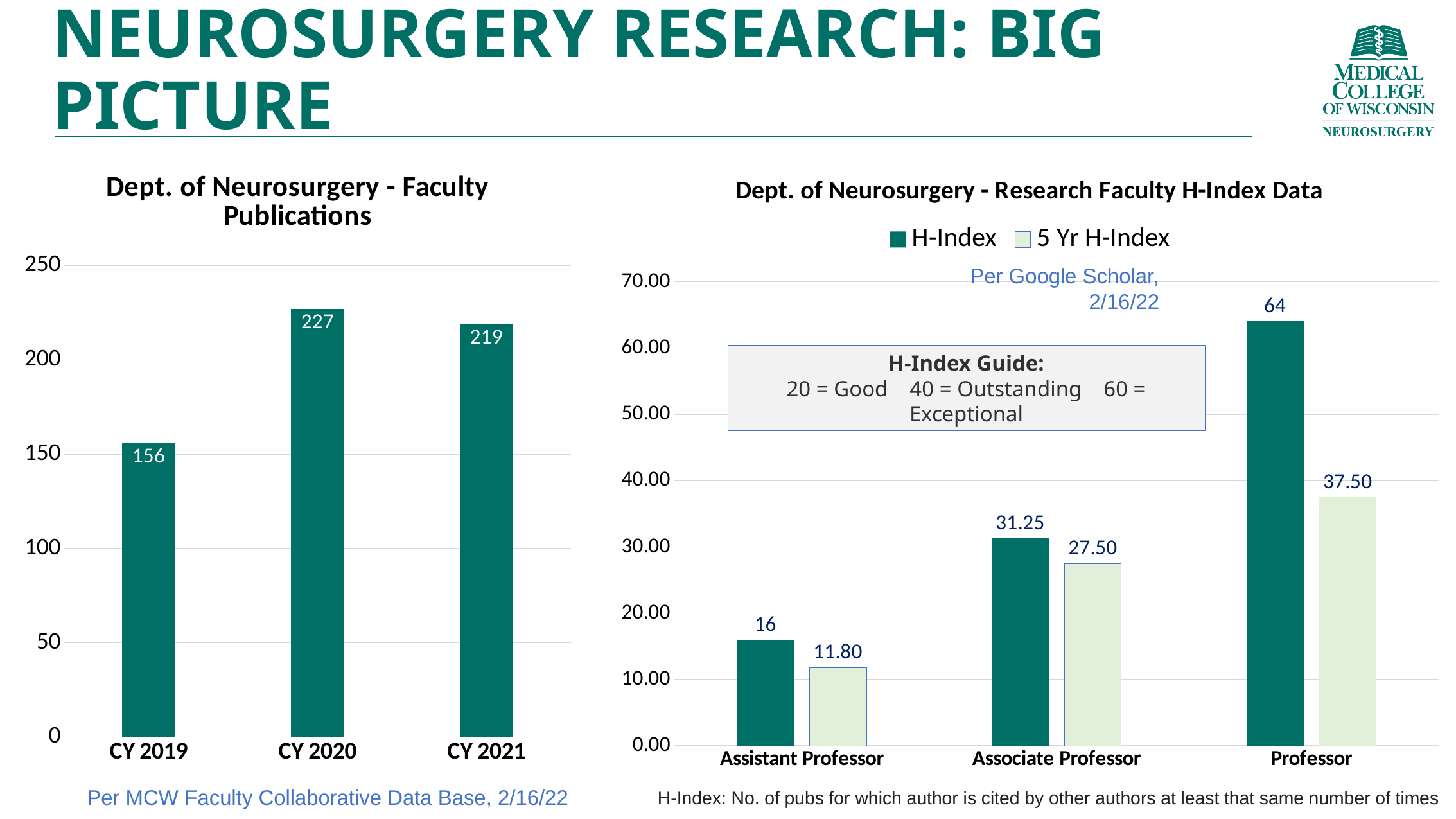
In the 'Dept. of Neurosurgery - Faculty Publications' chart, is the value for CY 2019 greater or less than 150? greater In the 'Dept. of Neurosurgery - Research Faculty H-Index Data' chart, what is the difference between the H-Index and the 5 Yr H-Index for Assistant Professor? 4.20 What kind of chart is the 'Dept. of Neurosurgery - Research Faculty H-Index Data' chart? Bar chart In the 'Dept. of Neurosurgery - Research Faculty H-Index Data' chart, what is the H-Index for Associate Professor? 31.25 In the 'Dept. of Neurosurgery - Faculty Publications' chart, how many years are shown? 3 In the 'Dept. of Neurosurgery - Research Faculty H-Index Data' chart, which is larger: the 5 Yr H-Index for Associate Professor or the H-Index for Assistant Professor? 5 Yr H-Index for Associate Professor In the 'Dept. of Neurosurgery - Faculty Publications' chart, what is the difference between CY 2020 and CY 2021? 8 In the 'Dept. of Neurosurgery - Research Faculty H-Index Data' chart, how many series does the legend list? 2 In the 'Dept. of Neurosurgery - Faculty Publications' chart, which year has the lowest number of publications? CY 2019 In the 'Dept. of Neurosurgery - Research Faculty H-Index Data' chart, what is the 5 Yr H-Index for Professor? 37.50 In the 'Dept. of Neurosurgery - Faculty Publications' chart, what is the value for CY 2020? 227 In the 'Dept. of Neurosurgery - Research Faculty H-Index Data' chart, which rank has the highest H-Index? Professor